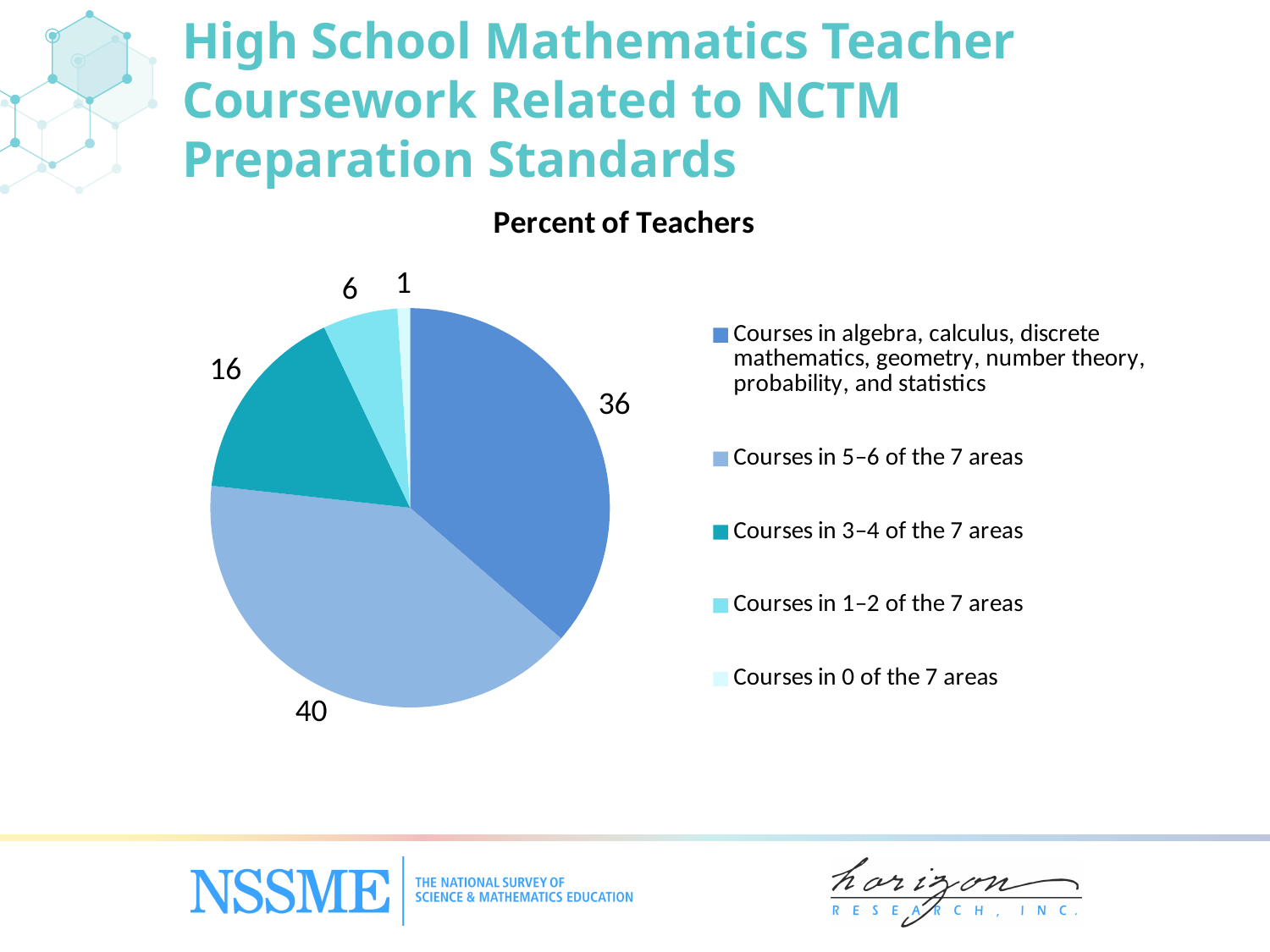
What is the difference between the values for 'Courses in 5–6 of the 7 areas' and 'Courses in 3–4 of the 7 areas'? 24 What is the value for 'Courses in 0 of the 7 areas'? 1 How many slices does the pie chart have? 5 What is the chart's title? Percent of Teachers Which category has the smallest slice? Courses in 0 of the 7 areas What is the value for 'Courses in 3–4 of the 7 areas'? 16 Which category has the largest slice? Courses in 5–6 of the 7 areas What kind of chart is shown on the slide? pie chart What is the value for 'Courses in 1–2 of the 7 areas'? 6 How many entries does the legend list? 5 What is the value for 'Courses in 5–6 of the 7 areas'? 40 Which is larger: the value for 'Courses in 3–4 of the 7 areas' or 'Courses in 1–2 of the 7 areas'? Courses in 3–4 of the 7 areas